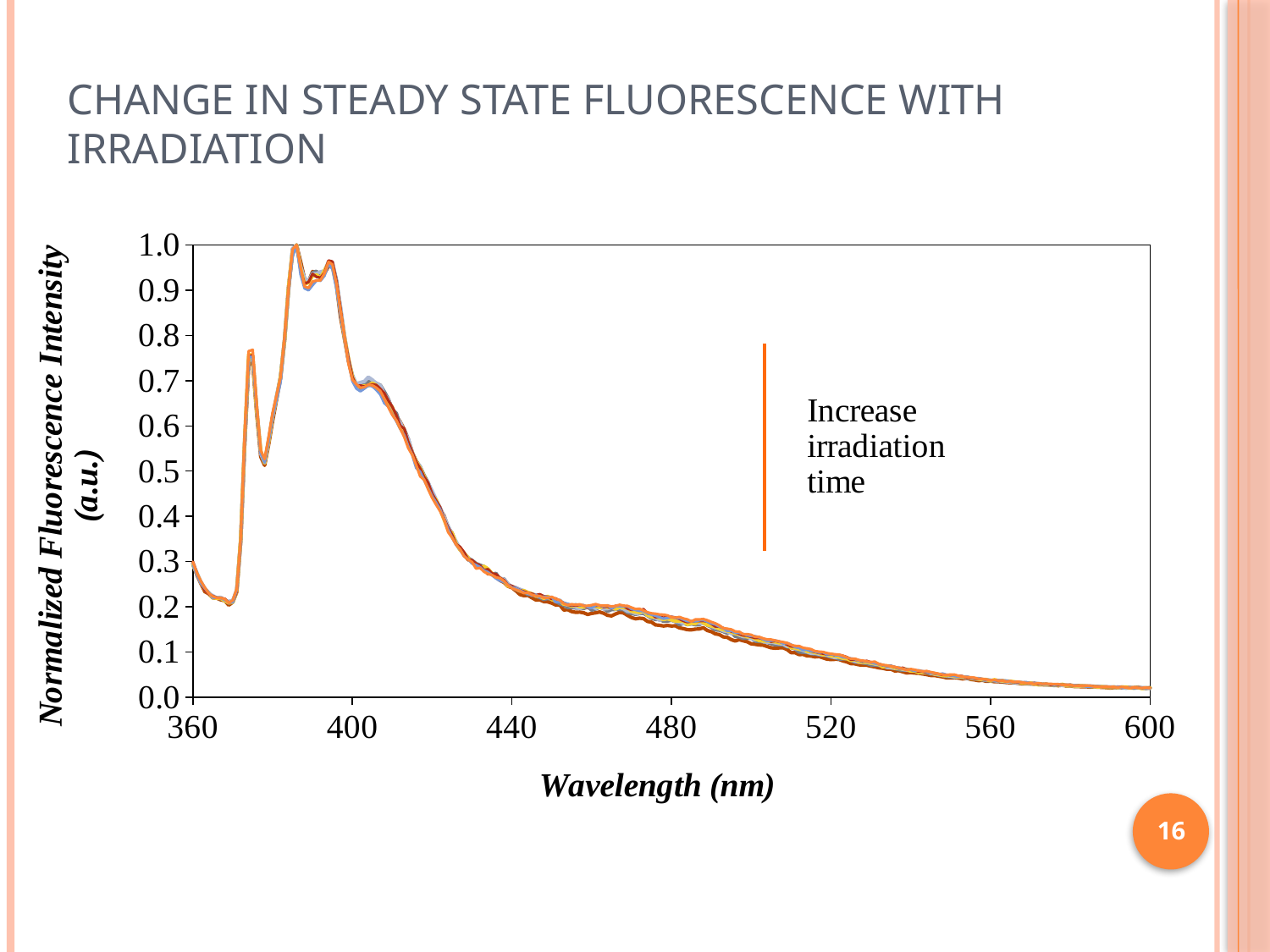
What is the highest value shown on the y axis of the chart? 1.0 What is the label of the y axis of the chart? Normalized Fluorescence Intensity (a.u.) Is the normalized fluorescence intensity at 400 nm greater or less than 0.5? greater What kind of chart is shown on the slide? line chart Is the normalized fluorescence intensity at 480 nm greater or less than 0.3? less Is the normalized fluorescence intensity at 560 nm greater or less than 0.2? less Do the values rise or fall along the x axis between 440 nm and 600 nm? fall Is the value at 400 nm larger or smaller than the value at 480 nm? larger What is the label of the x axis of the chart? Wavelength (nm)